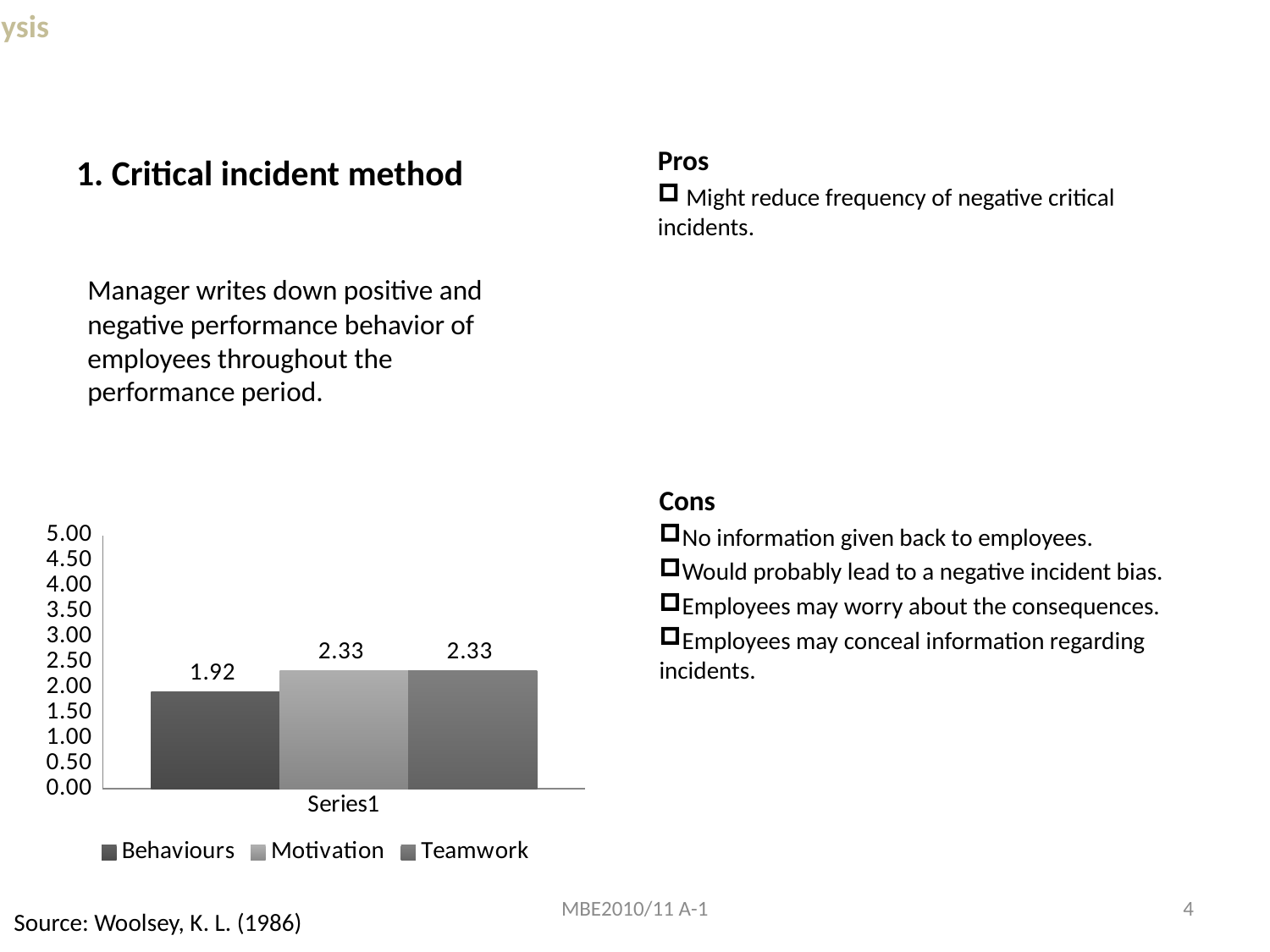
Which series has the lowest value in the chart? Behaviours What is the highest value shown on the y axis of the chart? 5.00 Is the value for Teamwork greater or less than 3.00? less What is the label shown on the x axis of the chart? Series1 What is the value for Teamwork in the chart? 2.33 What kind of chart is shown on the slide? bar chart Is the value for Behaviours greater or less than 1.50? greater What is the difference between the Motivation value and the Behaviours value? 0.41 What is the value for Behaviours in the chart? 1.92 How many series does the legend of the chart list? 3 What is the value for Motivation in the chart? 2.33 Which is larger, the value for Behaviours or the value for Motivation? Motivation